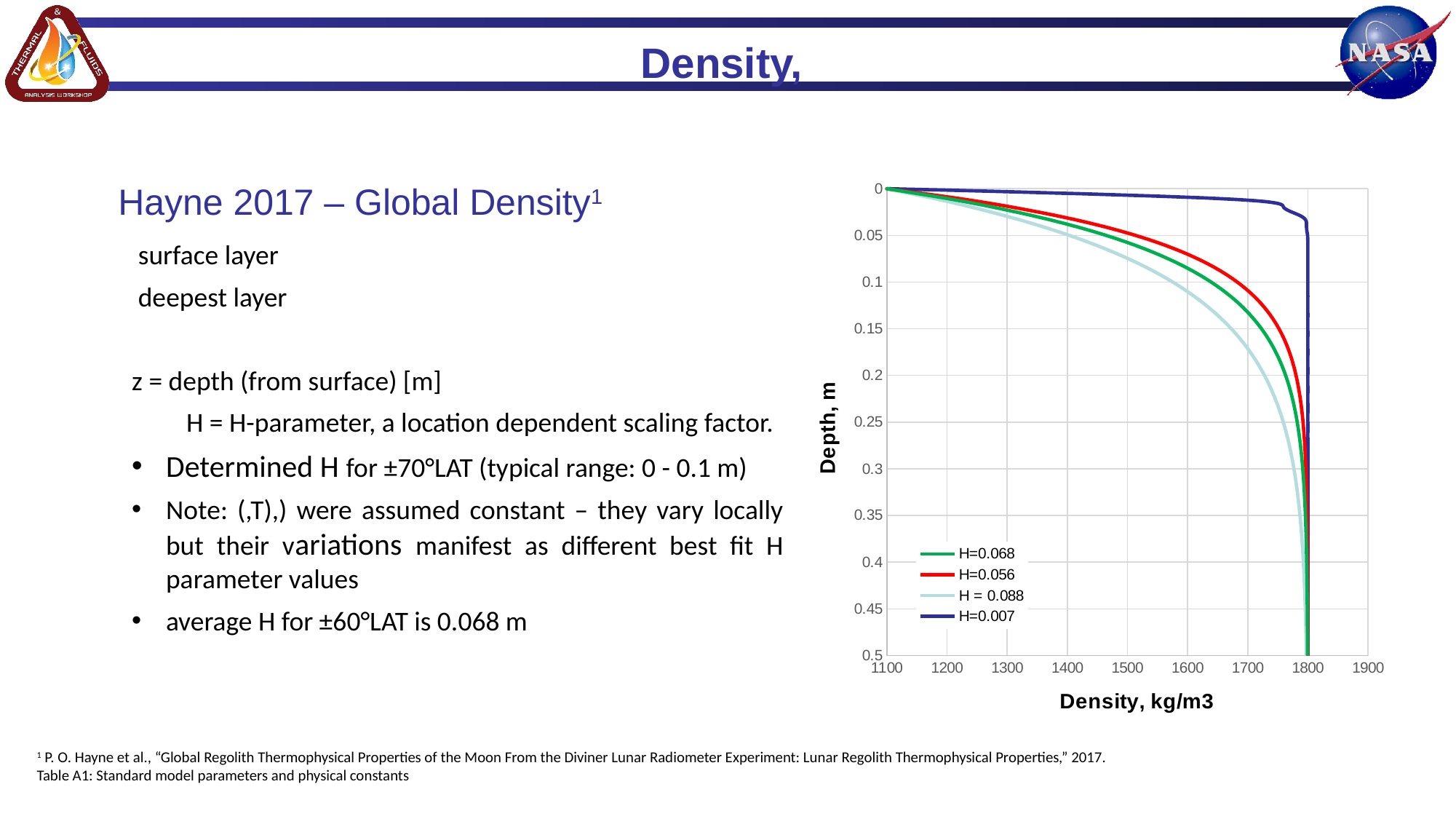
What is the title of the horizontal axis of the chart? Density, kg/m3 For the H=0.068 series, does density increase or decrease as depth increases from 0 to 0.5 m? increase At a depth of 0.1 m, is the density for the H=0.068 series greater or less than 1500? greater At a depth of 0.05 m, which series has the highest density? H=0.007 At a depth of 0.1 m, which series has the higher density, H=0.007 or H = 0.088? H=0.007 At a depth of 0.1 m, is the density for the H=0.007 series greater or less than 1700? greater At a depth of 0.05 m, is the density for the H = 0.088 series greater or less than 1500? less How many series does the chart legend list? 4 What kind of chart is shown on the slide? line chart What is the title of the vertical axis of the chart? Depth, m At a depth of 0.15 m, which series has the lowest density? H = 0.088